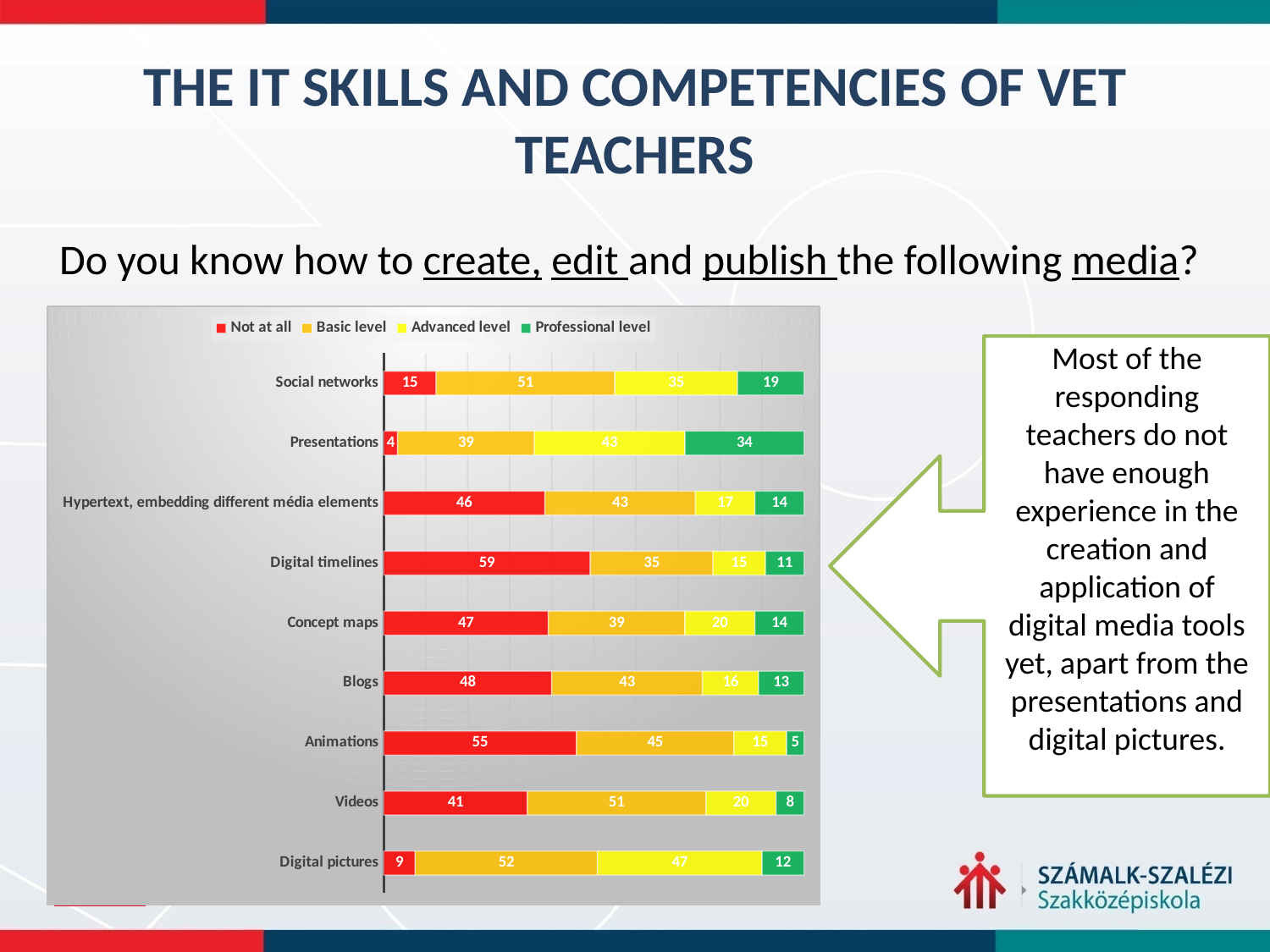
How many media categories are plotted in the chart? 9 What is the difference between the 'Advanced level' values for Digital pictures and Blogs? 31 What is the 'Professional level' value for Presentations? 34 What is the total of the stacked bar for Animations? 120 Which has the larger 'Professional level' value, Social networks or Digital pictures? Social networks How many series does the chart legend list? 4 Which category has the highest 'Not at all' value? Digital timelines Which colour represents 'Not at all' in the chart legend? Red What is the 'Advanced level' value for Concept maps? 20 Which category has the lowest 'Not at all' value? Presentations What kind of chart is shown on the slide? Stacked bar chart What is the 'Not at all' value for Digital timelines? 59